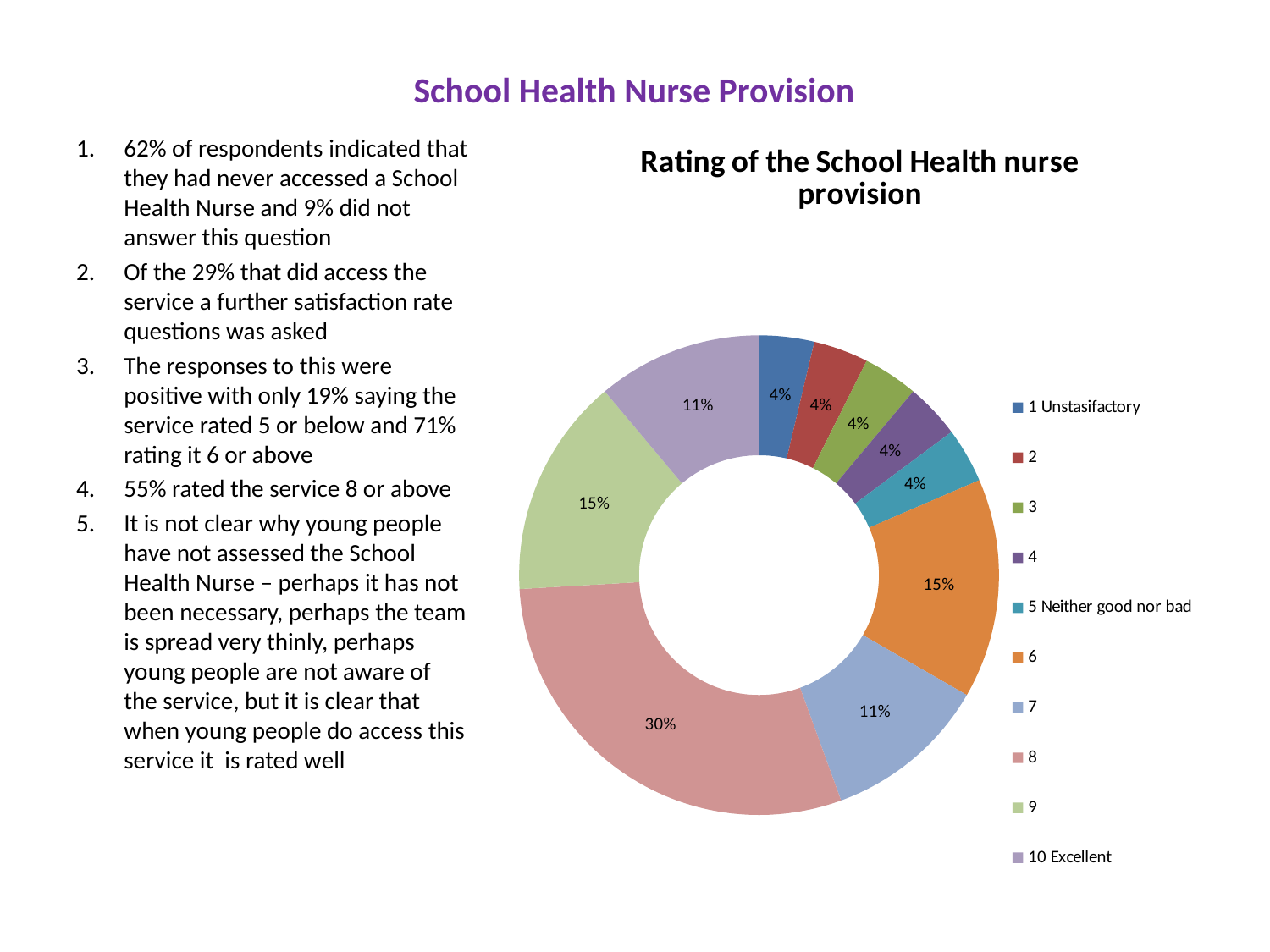
Which is larger: the share rating the provision 9 or the share rating it 10 Excellent? 9 What share of respondents rated the provision 1 Unstasifactory? 4% What label does the legend give to the rating of 5? 5 Neither good nor bad What percentage of respondents gave a rating of 6? 15% How many rating categories are shown in the chart? 10 What share of respondents rated the School Health nurse provision 8? 30% What is the combined share of respondents who rated the provision 6 or 7? 26% What percentage of respondents rated the provision 10 Excellent? 11% What type of chart is used to show the rating of the School Health nurse provision? Doughnut chart What is the difference between the share rating the provision 8 and the share rating it 7? 19% Which rating received the largest share of responses? 8 What is the title of the chart? Rating of the School Health nurse provision